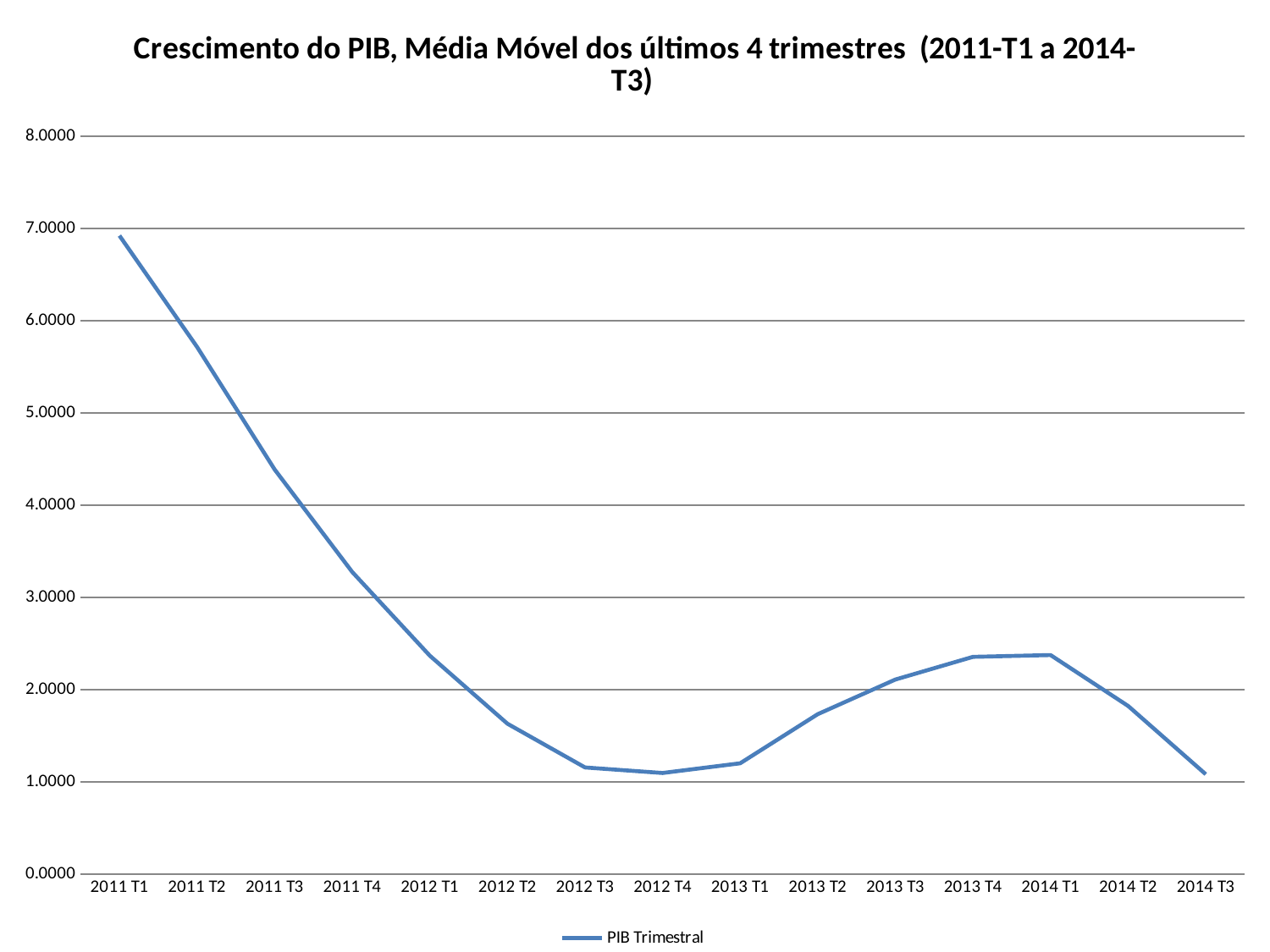
Is the value for 2013 T4 greater or less than 2.0000? greater Which is larger, the value for 2011 T4 or the value for 2014 T2? 2011 T4 Is the value for 2011 T3 greater or less than 4.0000? greater Do the values rise or fall from 2011 T1 to 2012 T4? fall What kind of chart is shown on the slide? line chart What is the name of the series shown in the legend? PIB Trimestral Is the value for 2014 T2 greater or less than 2.0000? less How many series does the legend list? 1 How many quarters are plotted along the x axis? 15 Which quarter has the highest value? 2011 T1